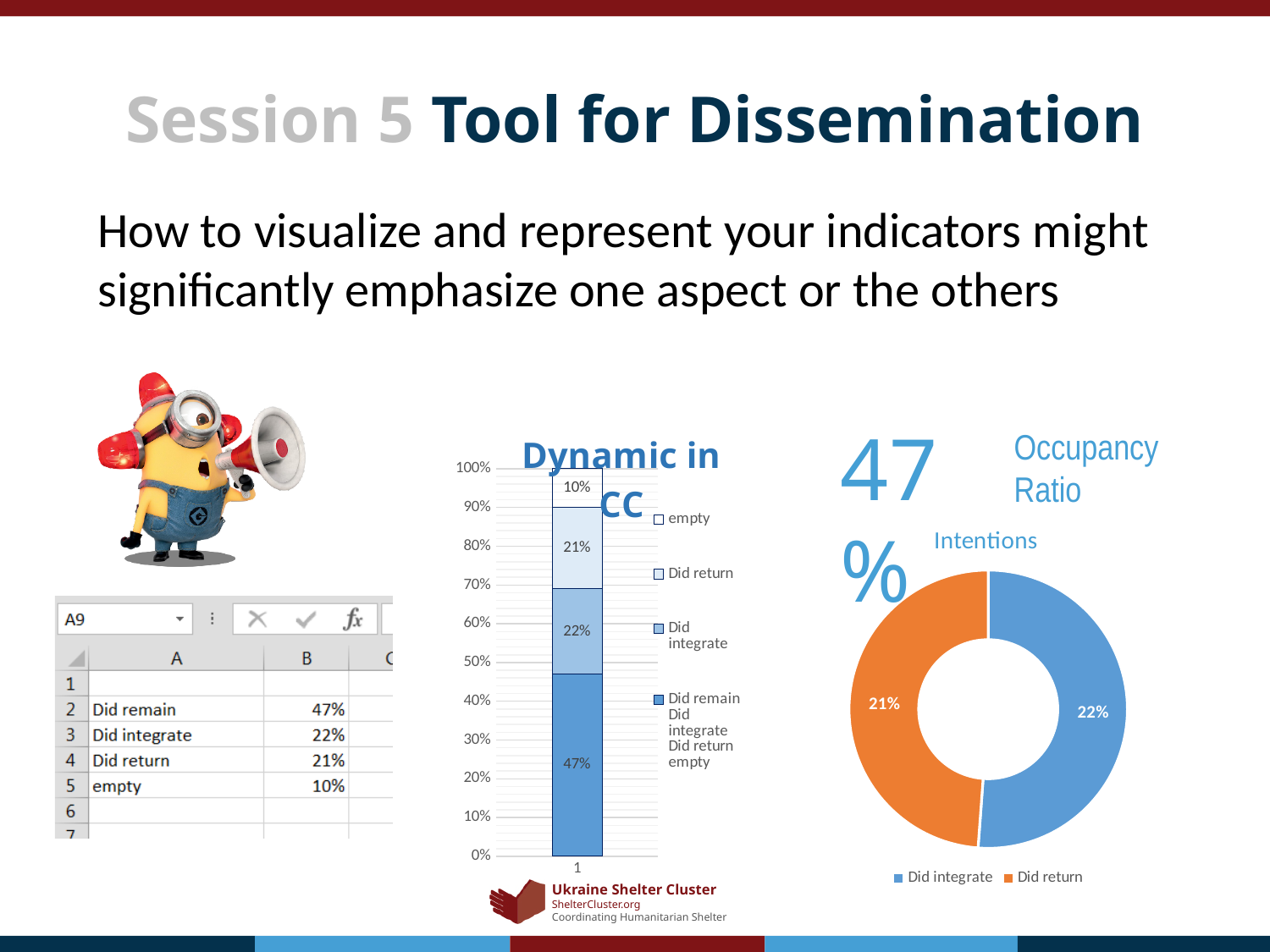
In the stacked bar chart on the left, which segment is the largest? Did remain In the stacked bar chart on the left, what is the value for empty? 10% What kind of chart is the Intentions chart on the right? Doughnut chart In the Intentions doughnut chart, which is larger, Did integrate or Did return? Did integrate In the Intentions doughnut chart, what is the value for Did return? 21% In the stacked bar chart on the left, how many series does the legend list? 4 In the stacked bar chart on the left, which segment is the smallest? empty In the stacked bar chart on the left, what is the difference between Did remain and Did return? 26% In the Intentions doughnut chart, how many categories does the legend list? 2 In the stacked bar chart on the left, what is the total of all segments in the bar? 100% In the stacked bar chart on the left, what is the value for Did integrate? 22% In the stacked bar chart on the left, what is the value for Did remain? 47%